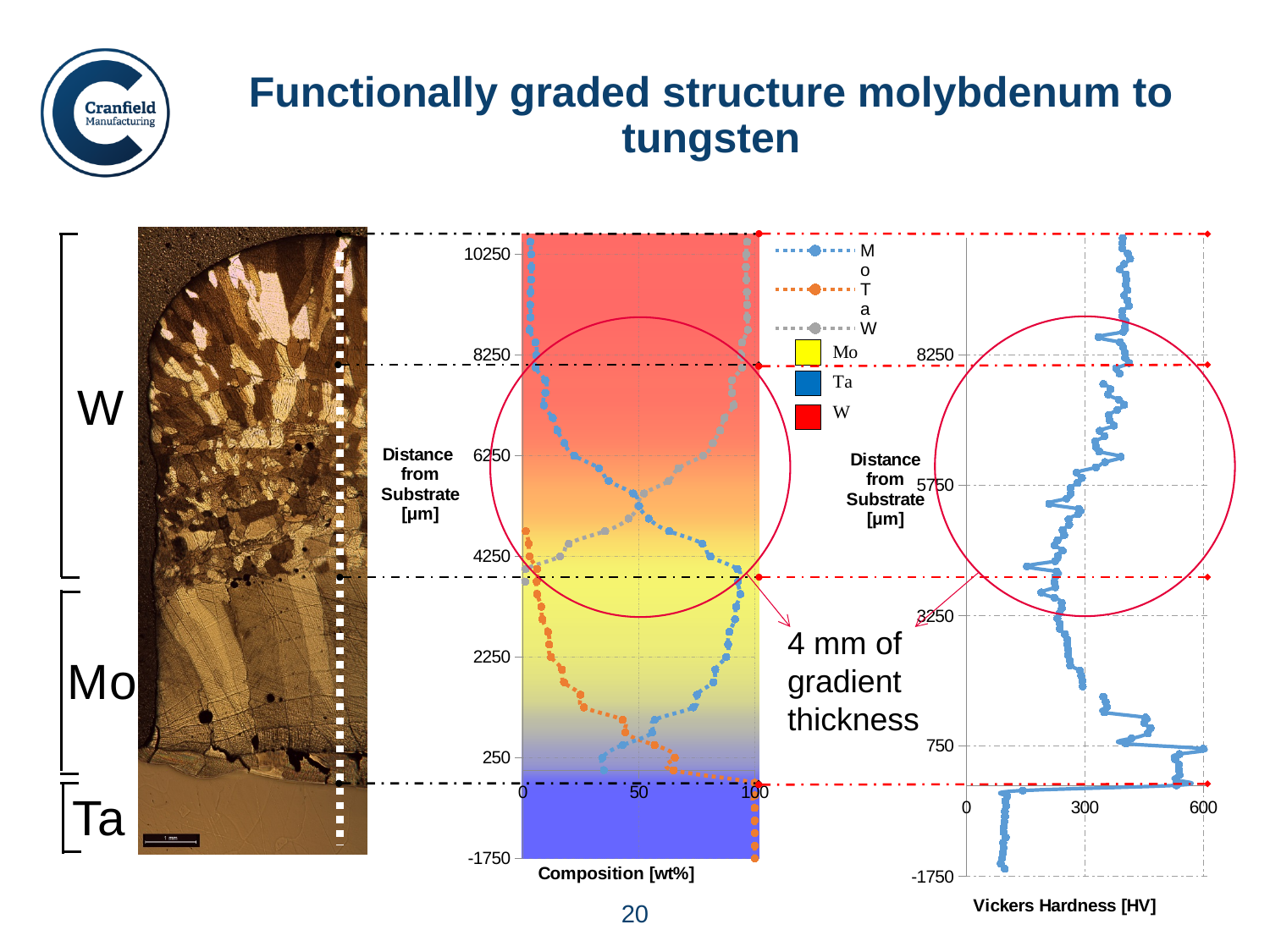
In the Vickers Hardness chart, is the hardness at a distance of 8250 µm greater or less than 300 HV? greater What kind of chart is the Vickers Hardness chart on the right of the slide? line chart In the composition chart, is the W composition at a distance of 10250 µm greater or less than 50 wt%? greater In the composition chart, is the Mo composition at a distance of 2250 µm greater or less than 50 wt%? greater In the Vickers Hardness chart, what is the highest value shown on the x-axis? 600 What is the x-axis title of the right-hand chart? Vickers Hardness [HV] In the composition chart, which three elements are plotted as series? Mo, Ta, W In the composition chart, which element has the higher composition at a distance of 2250 µm, Mo or Ta? Mo What is the x-axis title of the middle composition chart? Composition [wt%]